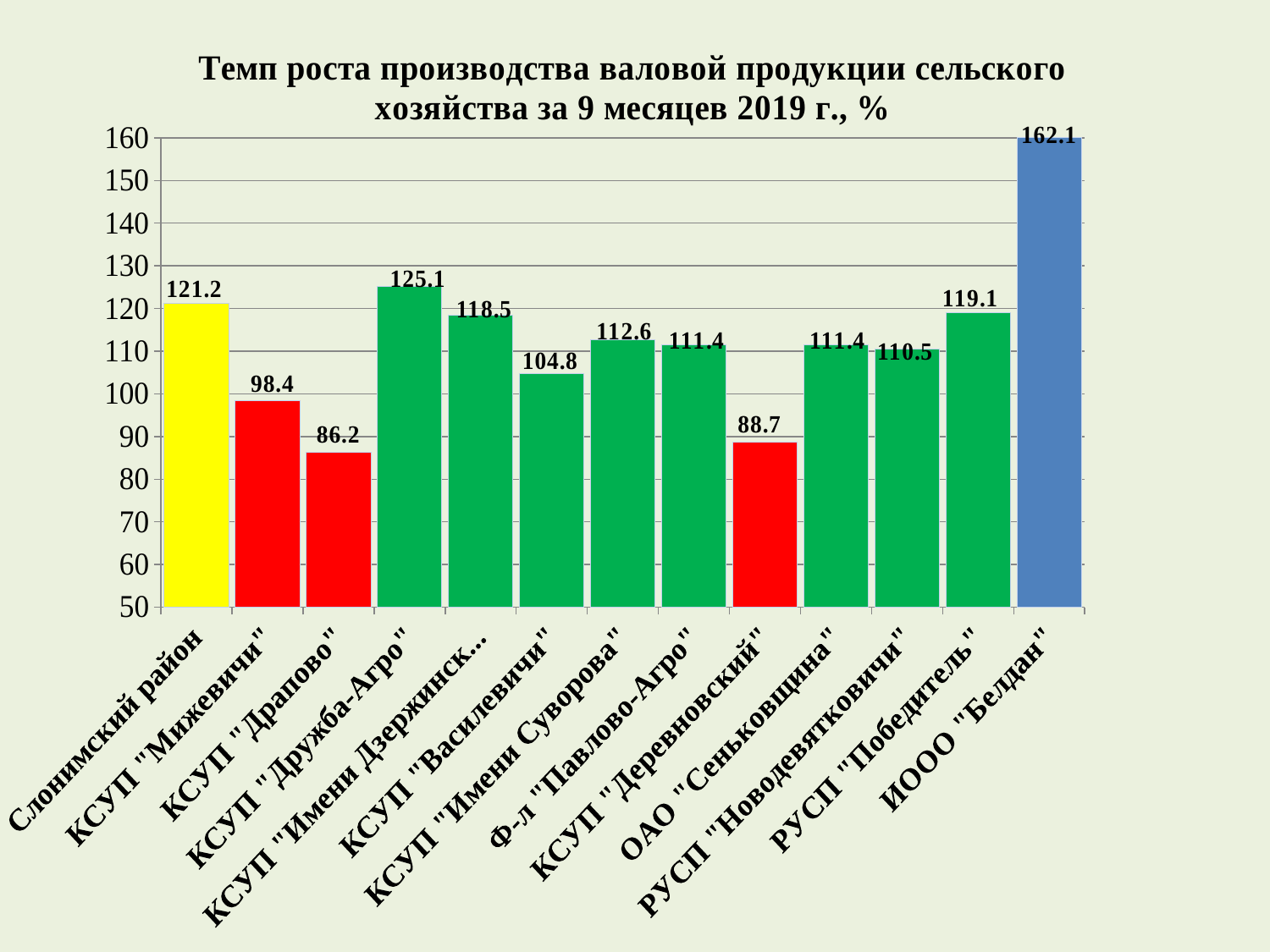
What is the title of the chart? Темп роста производства валовой продукции сельского хозяйства за 9 месяцев 2019 г., % What is the difference between the values for КСУП "Дружба-Агро" and Слонимский район? 3.9 What is the value for КСУП "Драпово"? 86.2 What is the value for Слонимский район? 121.2 What is the value for РУСП "Победитель"? 119.1 What is the value for ИООО "Белдан"? 162.1 What is the difference between the values for ИООО "Белдан" and КСУП "Драпово"? 75.9 Which is larger, the value for КСУП "Мижевичи" or the value for КСУП "Деревновский"? КСУП "Мижевичи" Which category has the highest value? ИООО "Белдан" Which category has the lowest value? КСУП "Драпово" How many categories are shown on the x axis? 13 What type of chart is shown on the slide? bar chart